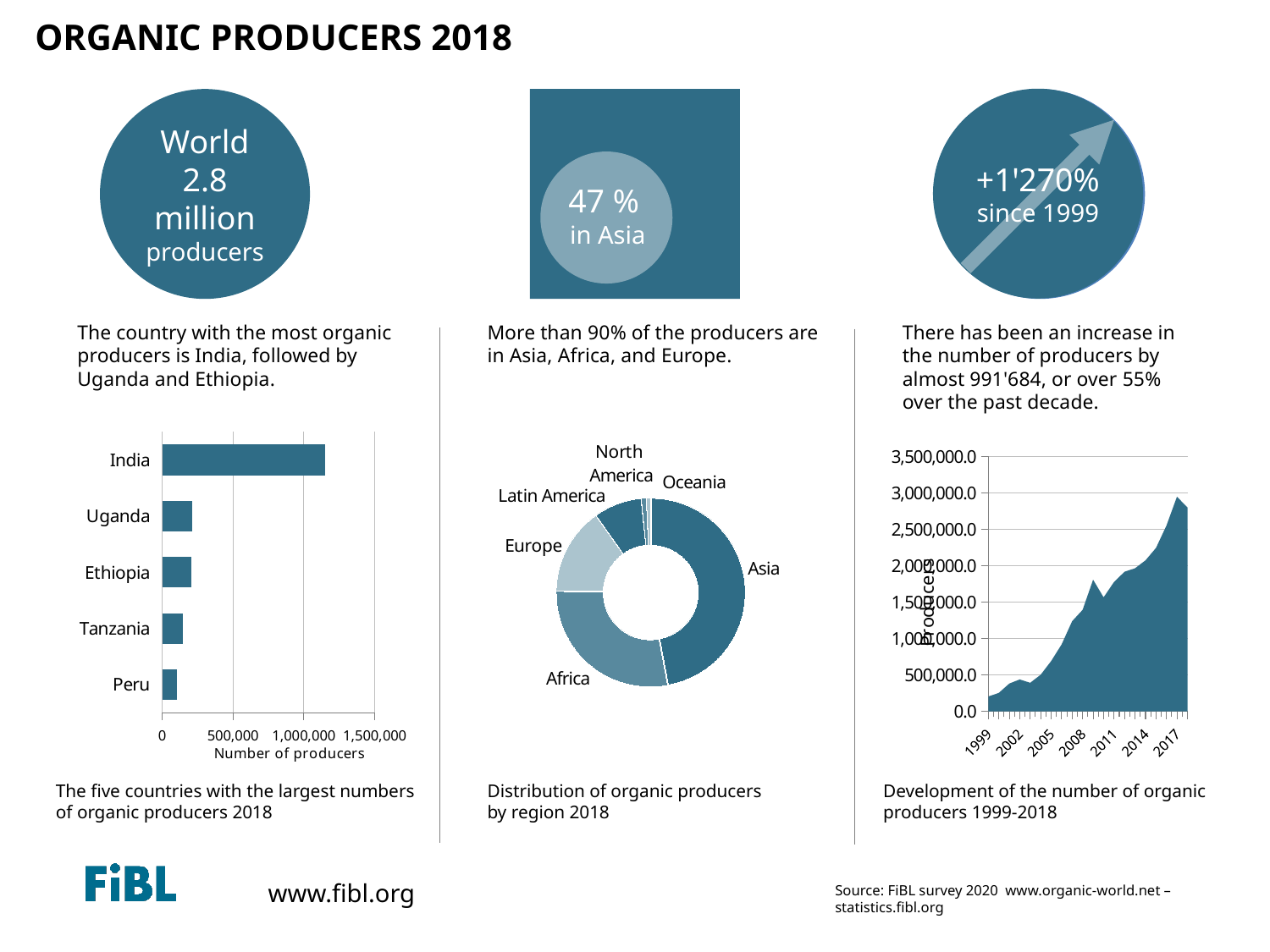
On the chart of the five countries with the largest numbers of organic producers, is the value for Uganda greater or less than 500,000? less On the chart of the five countries with the largest numbers of organic producers, which has more producers, Tanzania or Peru? Tanzania On the chart of the distribution of organic producers by region 2018, which region has the smallest share? Oceania On the chart of the development of the number of organic producers 1999-2018, do the values generally rise or fall from 1999 to 2018? Rise On the chart of the five countries with the largest numbers of organic producers, which country has the most organic producers? India What kind of chart is the chart of the five countries with the largest numbers of organic producers? Bar chart On the chart of the distribution of organic producers by region 2018, how many regions are shown? 6 On the chart of the distribution of organic producers by region 2018, which region has the largest share? Asia On the chart of the five countries with the largest numbers of organic producers, which country has the fewest organic producers? Peru On the chart of the five countries with the largest numbers of organic producers, how many countries are shown? 5 On the chart of the five countries with the largest numbers of organic producers, is the value for India greater or less than 1,000,000? greater On the chart of the development of the number of organic producers 1999-2018, is the value for 2017 greater or less than 2,500,000.0? greater